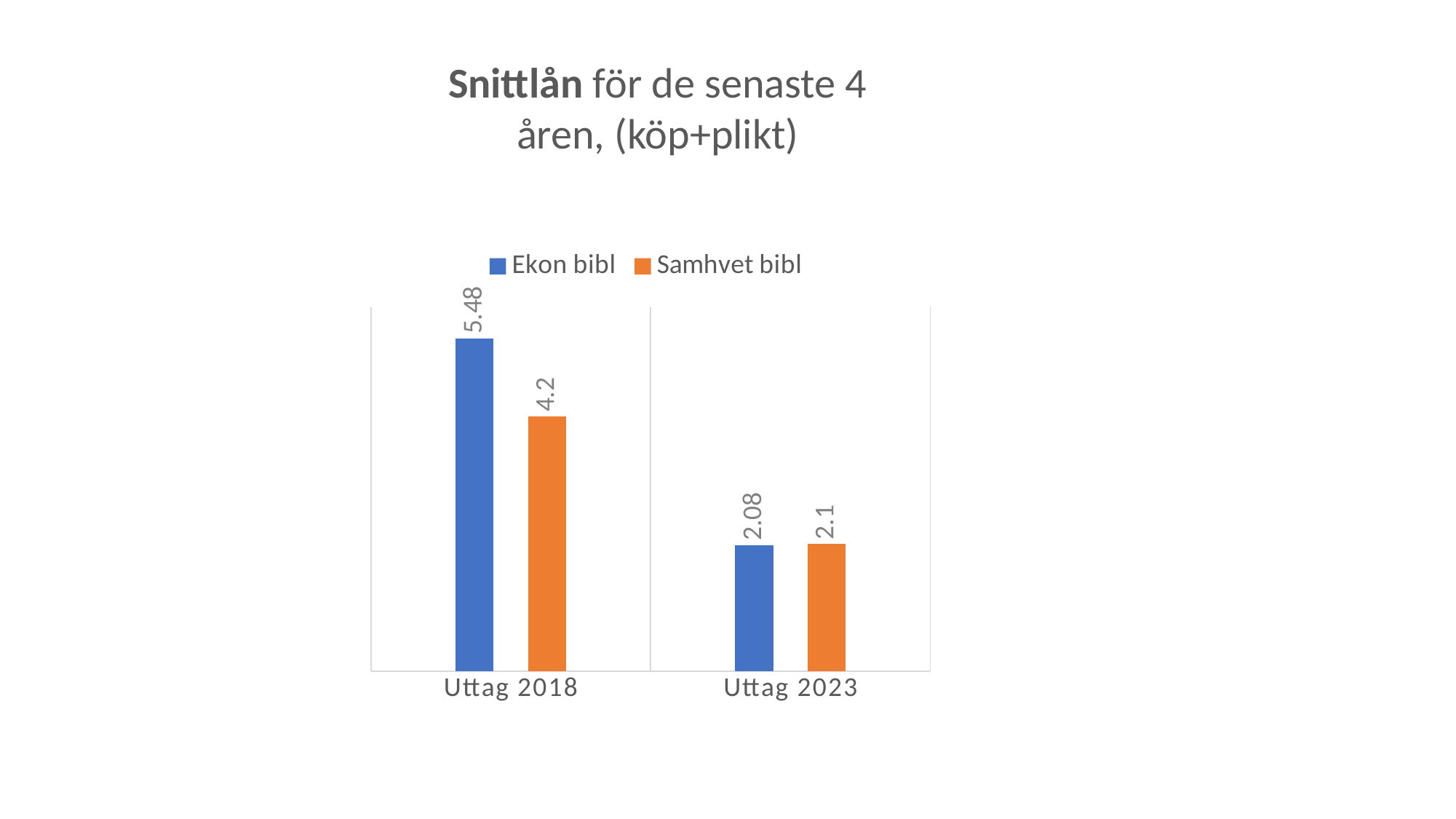
Which series has the highest value at Uttag 2018? Ekon bibl Which bar has the lowest value in the chart? Ekon bibl at Uttag 2023 What is the value for Ekon bibl at Uttag 2018? 5.48 What is the difference between the Ekon bibl values for Uttag 2018 and Uttag 2023? 3.4 What is the value for Samhvet bibl at Uttag 2023? 2.1 How many series does the legend list? 2 What is the difference between Ekon bibl and Samhvet bibl at Uttag 2018? 1.28 How many categories are shown on the x axis? 2 What is the value for Samhvet bibl at Uttag 2018? 4.2 What kind of chart is shown on the slide? Bar chart What is the value for Ekon bibl at Uttag 2023? 2.08 Which is larger for Samhvet bibl: Uttag 2018 or Uttag 2023? Uttag 2018